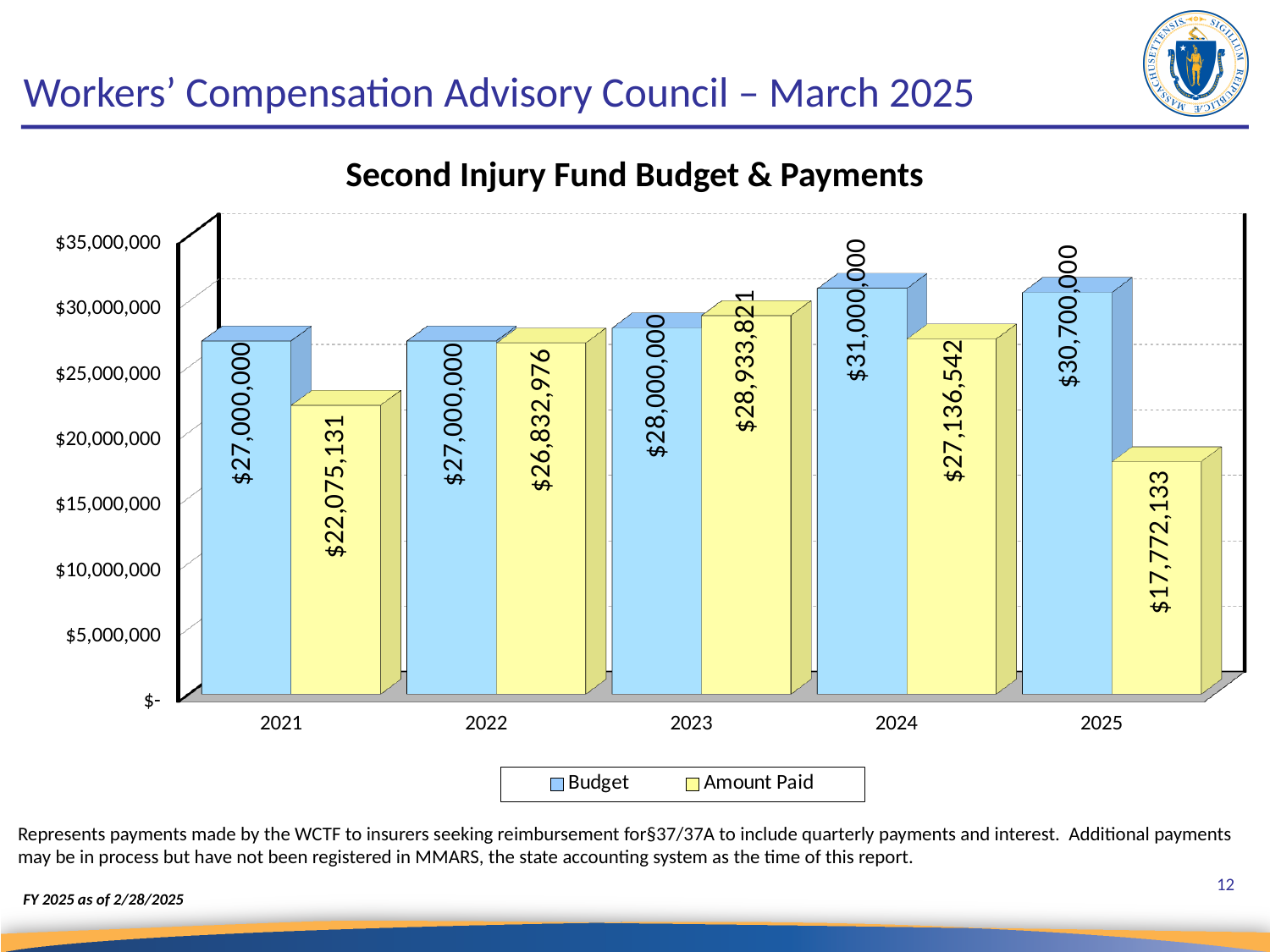
Is the Amount Paid for 2021 greater or less than $25,000,000? less What is the difference between the Budget and the Amount Paid in 2021? $4,924,869 Which year has the lowest Amount Paid? 2025 What is the Budget value for 2024? $31,000,000 What type of chart is shown on the slide? bar chart How many series does the legend list? 2 Which year has the highest Budget value? 2024 What is the Amount Paid for 2025? $17,772,133 In 2023, which is larger, the Budget or the Amount Paid? Amount Paid How many years are shown on the x axis? 5 What is the Amount Paid for 2022? $26,832,976 What is the difference between the Budget and the Amount Paid in 2025? $12,927,867